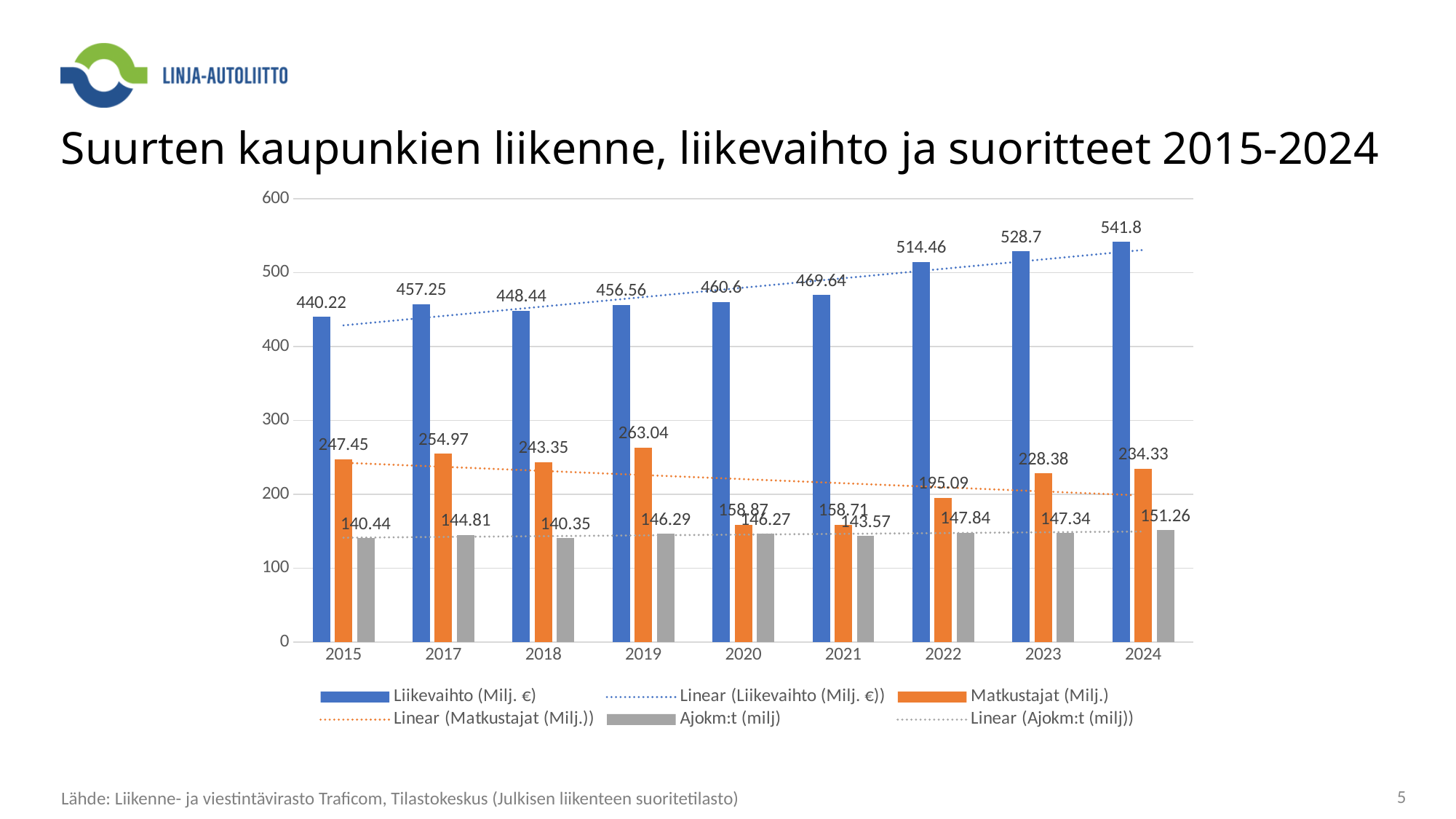
What is the difference between the Matkustajat (Milj.) values for 2019 and 2020? 104.17 How many entries does the legend list? 6 What kind of chart is shown on the slide? Bar chart In which year is the Matkustajat (Milj.) value highest? 2019 How many years are shown on the x axis? 9 Which year has the larger Matkustajat (Milj.) value, 2022 or 2023? 2023 In which year is the Liikevaihto (Milj. €) value lowest? 2015 What is the difference between the Liikevaihto (Milj. €) values for 2024 and 2015? 101.58 What is the Ajokm:t (milj) value for 2024? 151.26 Does the Liikevaihto (Milj. €) value generally rise or fall from 2015 to 2024? Rise What is the Liikevaihto (Milj. €) value for 2022? 514.46 What is the Matkustajat (Milj.) value for 2019? 263.04